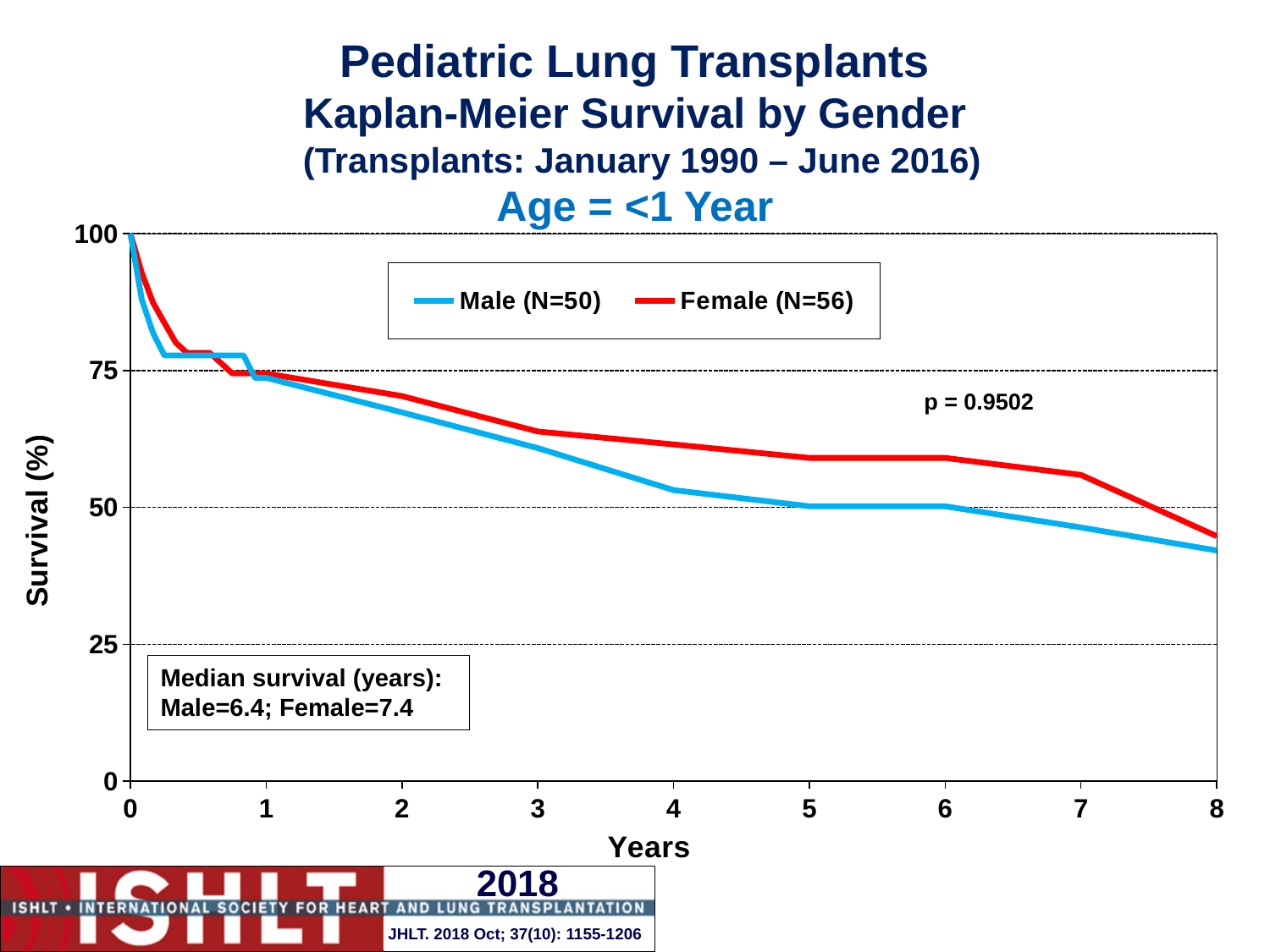
What is the N for the Female series in the legend? 56 Do the survival curves rise or fall as years increase? fall How many series does the legend list? 2 At 4 years, which series has the higher survival, Male or Female? Female What is the median survival in years for Male patients? 6.4 Is the Female survival at 5 years greater or less than 50? greater Is the Male survival at 2 years greater or less than 75? less What kind of chart is shown on the slide? line chart What is the p-value shown on the chart? p = 0.9502 What is the median survival in years for Female patients? 7.4 Is the Male survival at 8 years greater or less than 50? less Which colour is used for the Male (N=50) series? blue